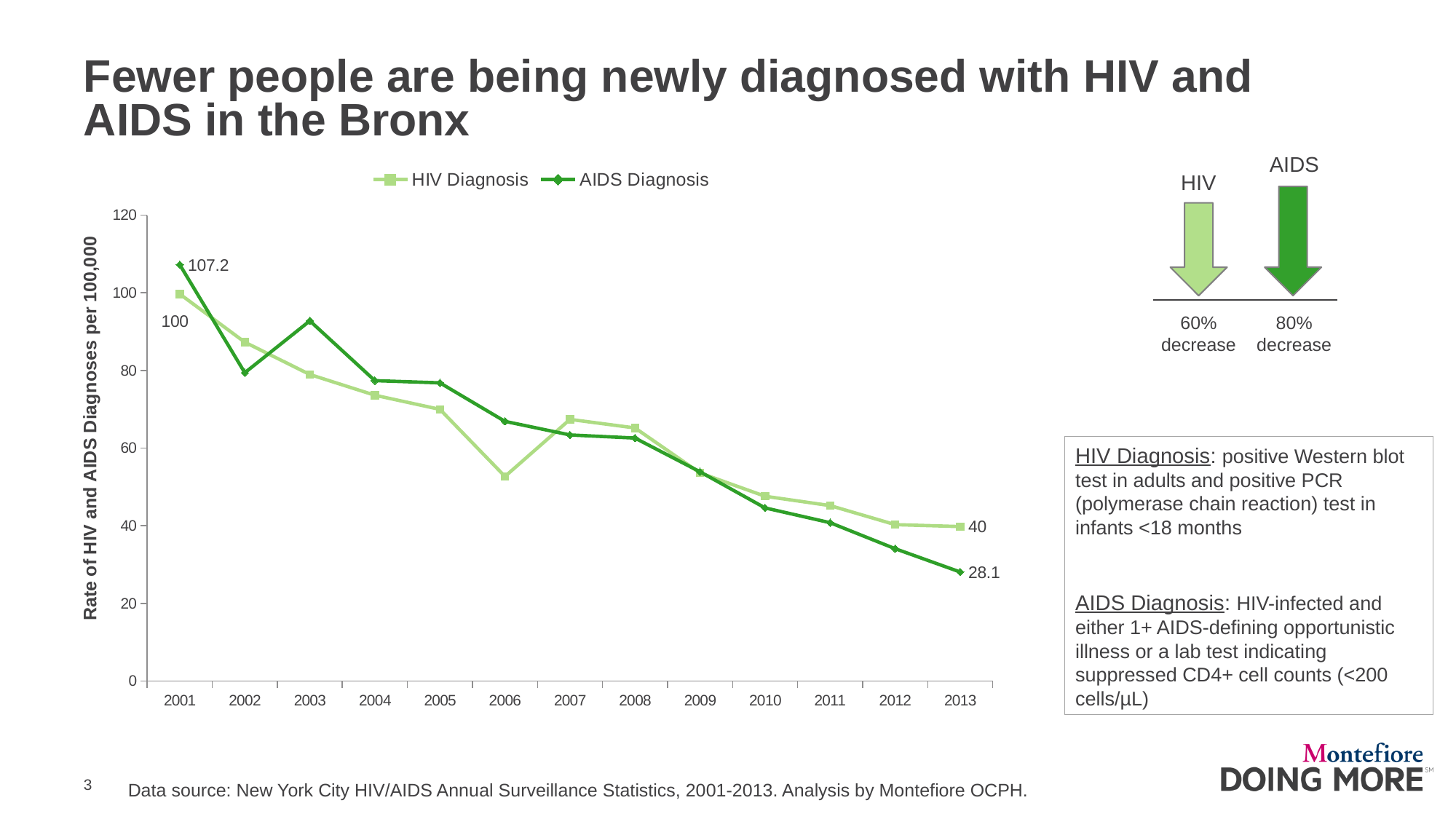
How many series does the chart's legend list? 2 What is the HIV Diagnosis rate in 2013? 40 What is the AIDS Diagnosis rate in 2001? 107.2 Is the HIV Diagnosis rate in 2006 greater or less than 60? less What is the HIV Diagnosis rate in 2001? 100 In 2013, which series has the higher rate, HIV Diagnosis or AIDS Diagnosis? HIV Diagnosis By how much did the HIV Diagnosis rate fall from 2001 to 2013? 60 What kind of chart is shown on the slide? Line chart By how much did the AIDS Diagnosis rate fall from 2001 to 2013? 79.1 How many years are shown on the x axis of the chart? 13 Is the AIDS Diagnosis rate in 2003 greater or less than 80? greater What is the AIDS Diagnosis rate in 2013? 28.1